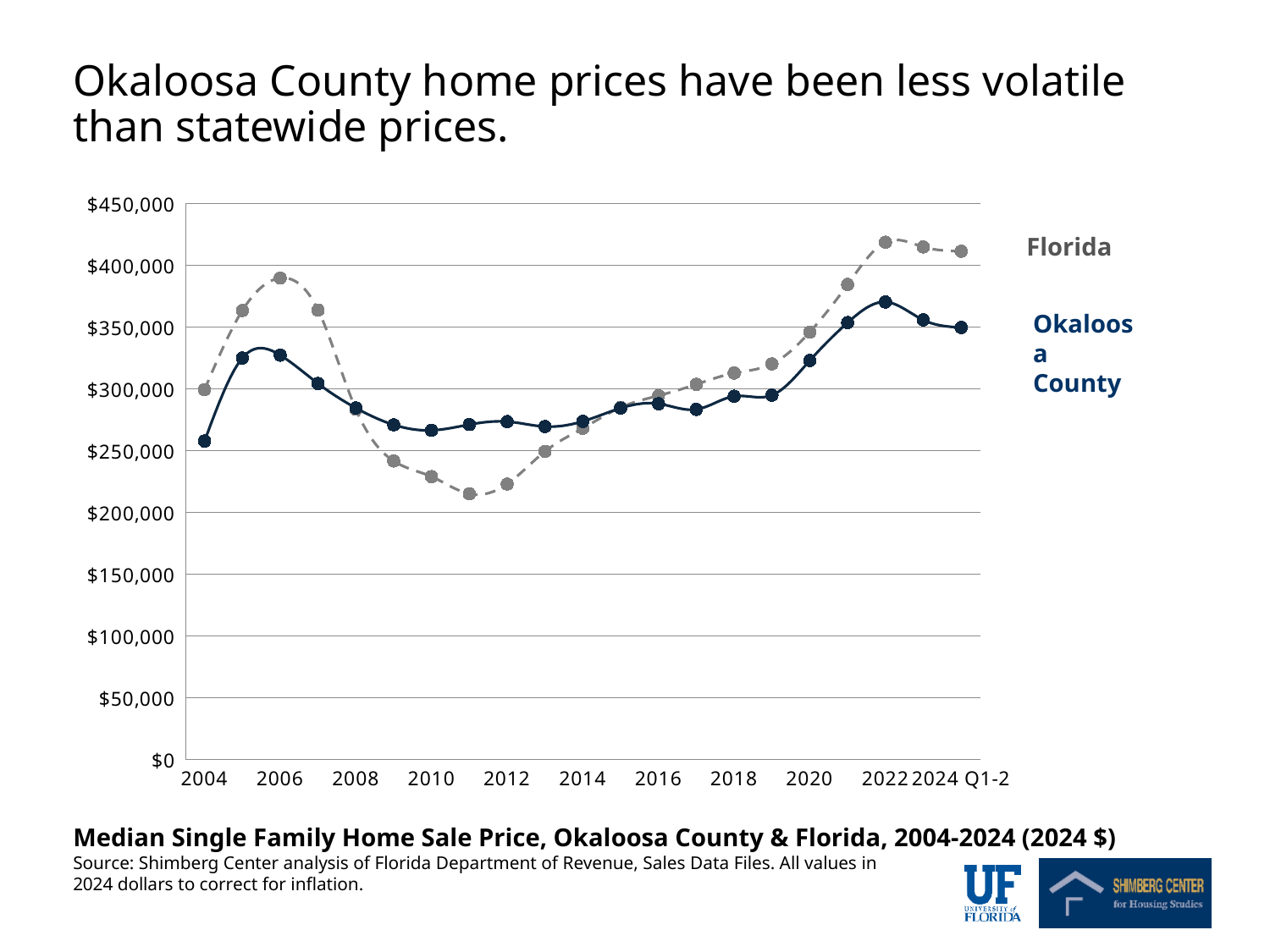
Do Florida values rise or fall from 2006 to 2011? Fall Is the Okaloosa County value for 2022 greater or less than $350,000? greater How many series does the chart show? 2 In 2006, which series has the higher value, Florida or Okaloosa County? Florida Is the Florida value for 2011 greater or less than $250,000? less Is the Florida value for 2022 greater or less than $400,000? greater In 2010, which series has the higher value, Florida or Okaloosa County? Okaloosa County What kind of chart is shown on the slide? Line chart In which year does the Florida series reach its highest value? 2022 What is the title of the chart? Median Single Family Home Sale Price, Okaloosa County & Florida, 2004-2024 (2024 $) What are the two series plotted on the chart? Florida and Okaloosa County